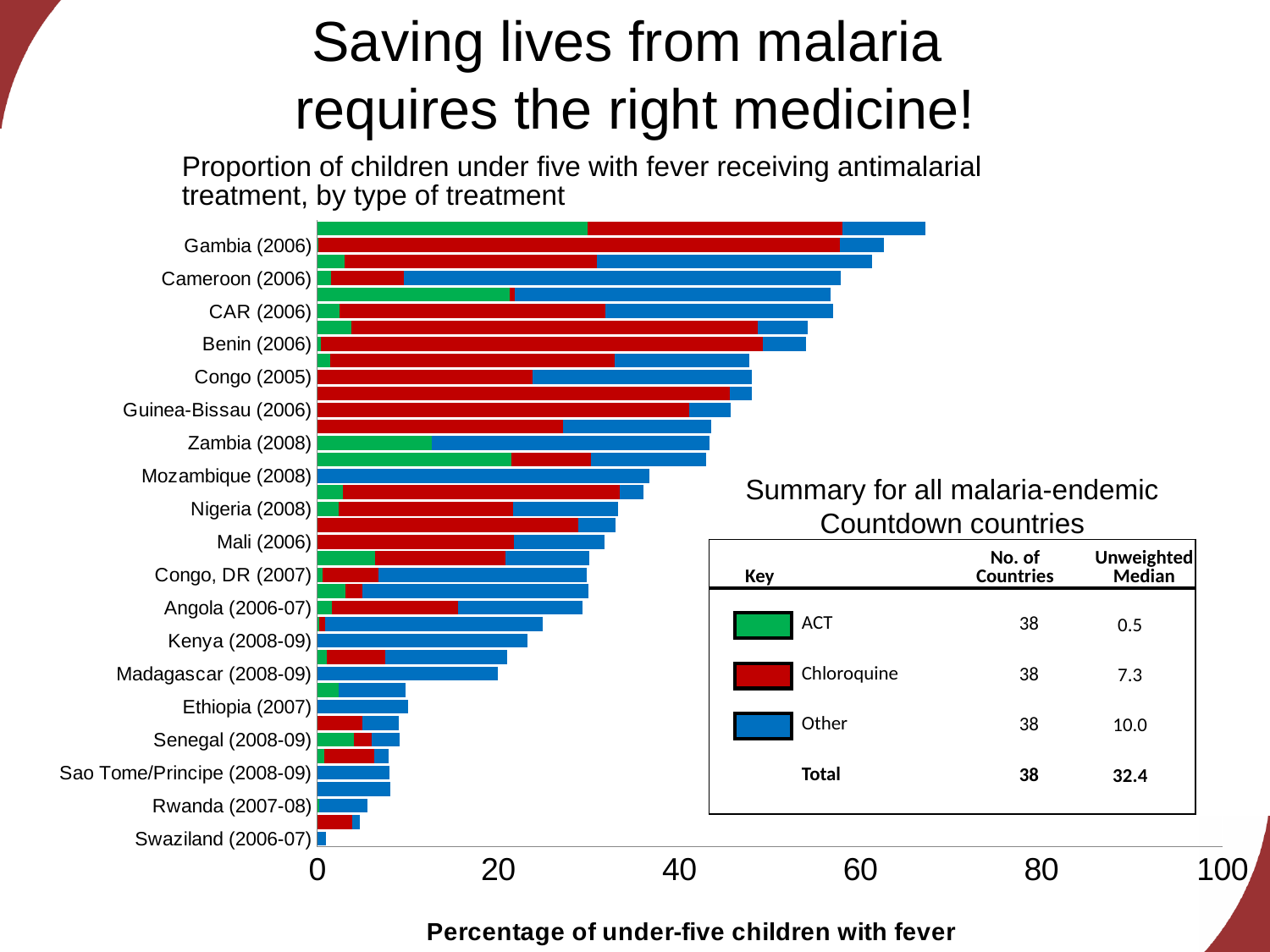
Which has the longer total bar, Congo (2005) or Senegal (2008-09)? Congo (2005) What colour represents ACT in the key? green Do the total bar lengths rise or fall going from the top of the chart to the bottom? fall Is the total bar length for Swaziland (2006-07) greater or less than 20? less Is the total bar length for Benin (2006) greater or less than 40? greater How many series does the key list for the chart? 3 What kind of chart is shown on the slide? bar chart Which has the longer total bar, Gambia (2006) or Swaziland (2006-07)? Gambia (2006) Is the total bar length for Cameroon (2006) greater or less than 40? greater